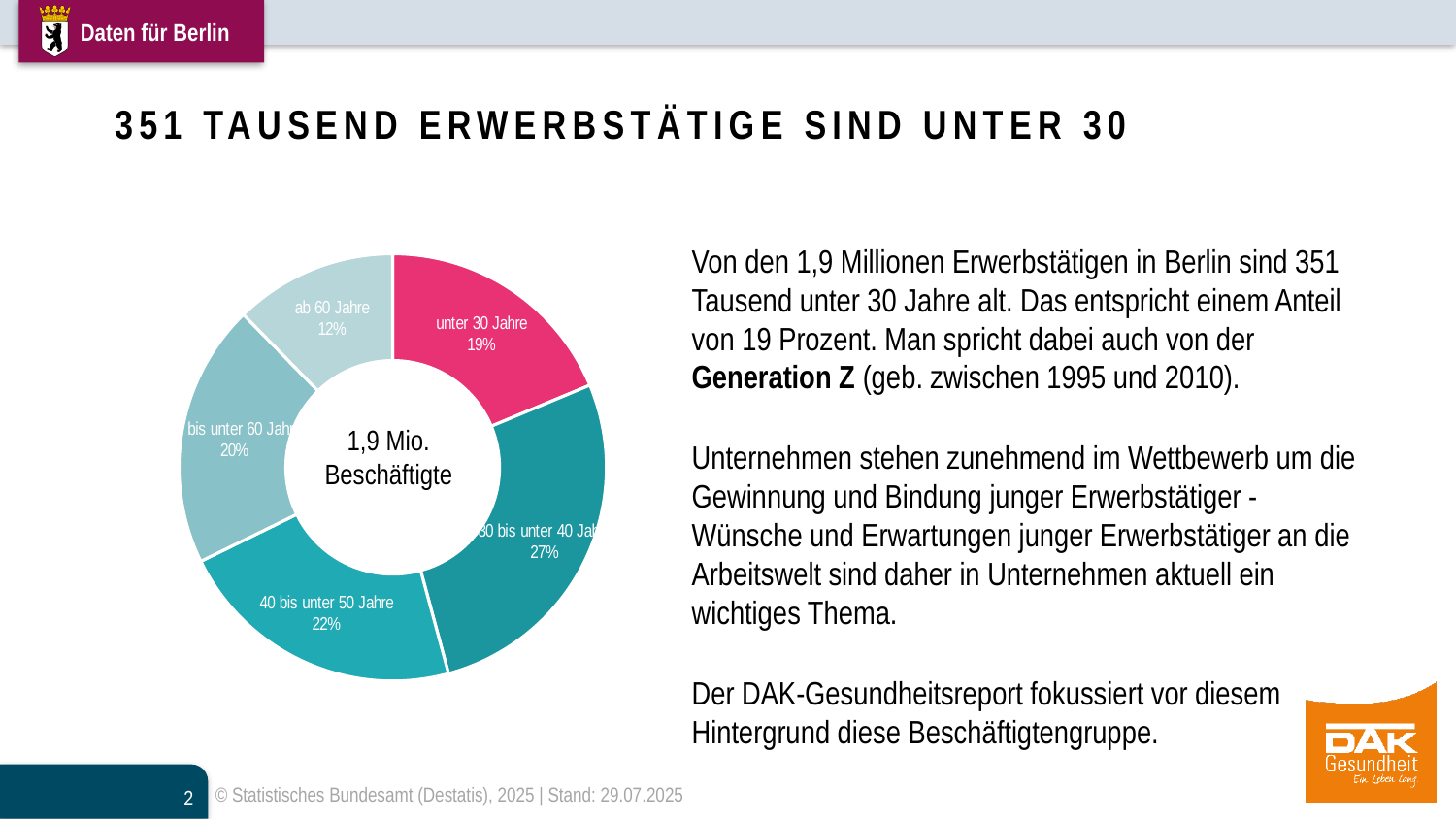
What percentage is shown for the slice 'ab 60 Jahre'? 12% What is the difference in percentage points between the '30 bis unter 40 Jahre' slice and the 'unter 30 Jahre' slice? 8 What percentage is shown for the slice '30 bis unter 40 Jahre'? 27% What colour is the 'unter 30 Jahre' slice in the doughnut chart? pink What text is shown in the centre of the doughnut chart? 1,9 Mio. Beschäftigte What percentage is shown for the slice '40 bis unter 50 Jahre'? 22% How many slices does the doughnut chart have? 5 What kind of chart is shown on the slide? doughnut chart Which age group has the smallest slice in the doughnut chart? ab 60 Jahre What share of the doughnut chart is the slice 'unter 30 Jahre'? 19% Which slice is larger, '40 bis unter 50 Jahre' or 'ab 60 Jahre'? 40 bis unter 50 Jahre Which age group has the largest slice in the doughnut chart? 30 bis unter 40 Jahre